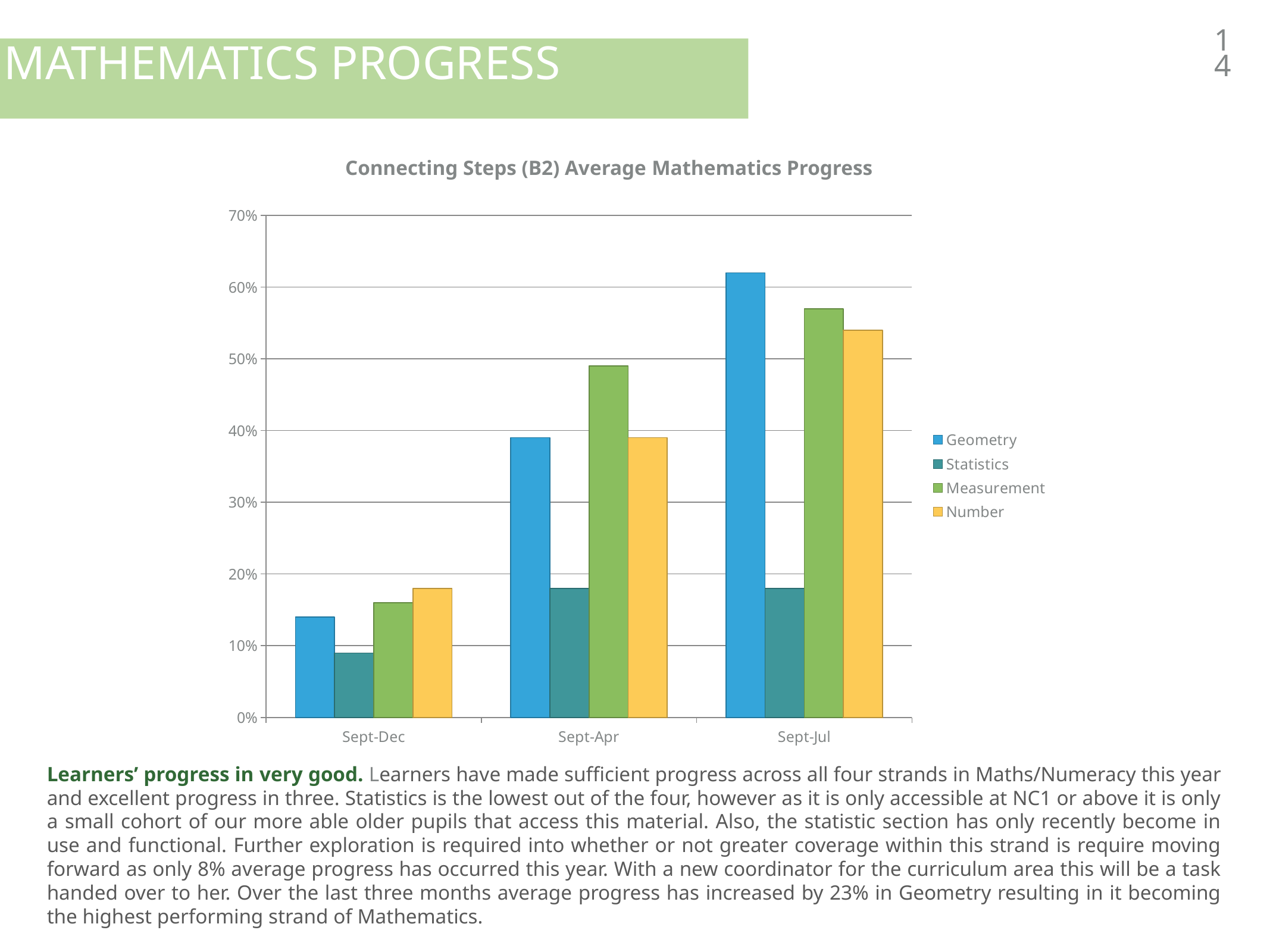
What kind of chart is shown on the slide? Bar chart Which series has the highest value in the Sept-Jul period? Geometry How many time periods are shown on the x axis? 3 Do the Geometry values rise or fall from Sept-Dec to Sept-Jul? Rise Is the value for Statistics in Sept-Apr greater or less than 20%? less In the Sept-Jul period, which is larger: Measurement or Number? Measurement How many series does the legend list? 4 What is the title of the chart? Connecting Steps (B2) Average Mathematics Progress Which series has the highest value in the Sept-Apr period? Measurement Is the value for Number in Sept-Jul greater or less than 50%? greater Which series has the lowest value in the Sept-Jul period? Statistics Is the value for Geometry in Sept-Jul greater or less than 60%? greater